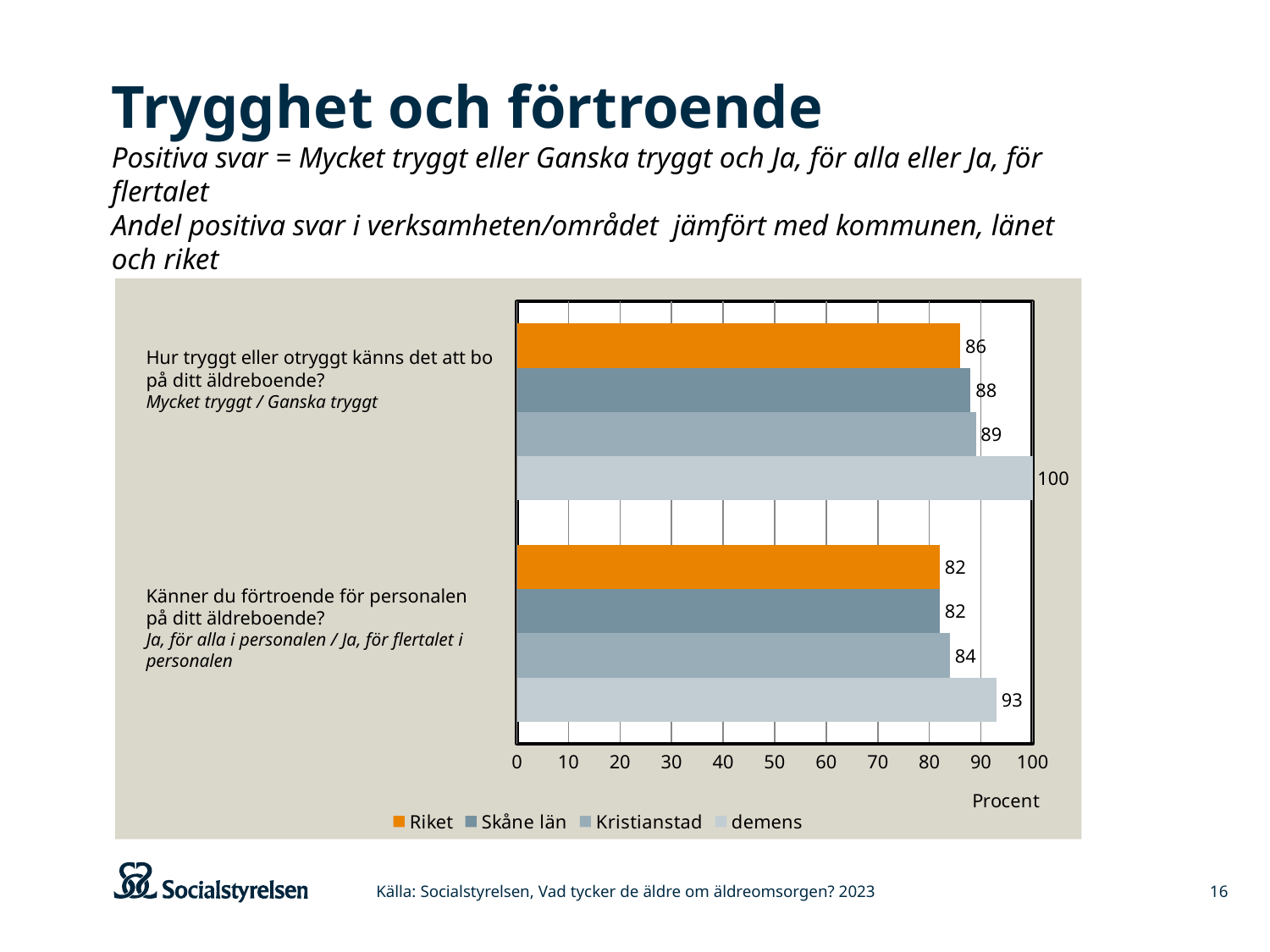
Which series has the highest value on the question "Känner du förtroende för personalen på ditt äldreboende?"? demens What is the value for demens on the question "Hur tryggt eller otryggt känns det att bo på ditt äldreboende?"? 100 What is the value for Riket on the question "Känner du förtroende för personalen på ditt äldreboende?"? 82 Which series has the lowest value on the question "Hur tryggt eller otryggt känns det att bo på ditt äldreboende?"? Riket How many series does the legend list? 4 What is the difference between the demens value and the Riket value on the question "Hur tryggt eller otryggt känns det att bo på ditt äldreboende?"? 14 What is the value for Kristianstad on the question "Hur tryggt eller otryggt känns det att bo på ditt äldreboende?"? 89 Which is larger: the Kristianstad value for the trygghet question or the Kristianstad value for the förtroende question? the trygghet question (89) What is the value for Skåne län on the question "Känner du förtroende för personalen på ditt äldreboende?"? 82 What unit is shown on the x axis of the chart? Procent What is the difference between the demens value and the Kristianstad value on the question "Känner du förtroende för personalen på ditt äldreboende?"? 9 What kind of chart is shown on the slide? bar chart